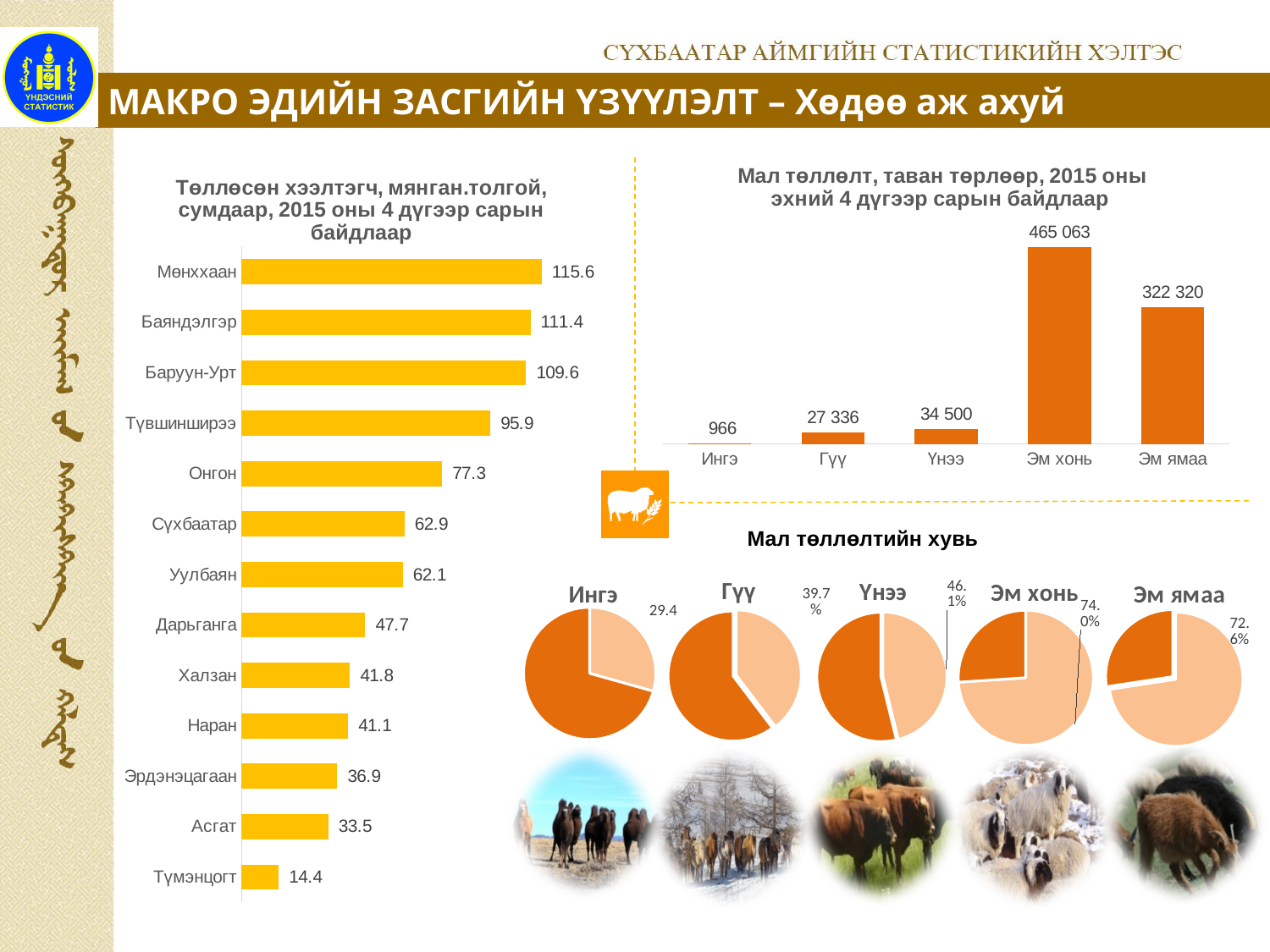
What kind of chart is 'Мал төллөлт, таван төрлөөр'? bar chart In the left bar chart (Төллөсөн хээлтэгч), which sum has the lowest value? Түмэнцогт In the left bar chart (Төллөсөн хээлтэгч), what is the difference between Онгон and Сүхбаатар? 14.4 In the chart titled 'Мал төллөлт, таван төрлөөр', what is the value for Эм хонь? 465 063 In the left bar chart (Төллөсөн хээлтэгч), what is the value for Мөнххаан? 115.6 In the 'Мал төллөлтийн хувь' pie charts, what share is labelled for Эм хонь? 74.0% In the chart titled 'Мал төллөлт, таван төрлөөр', what is the difference between Үнээ and Гүү? 7 164 In the left bar chart (Төллөсөн хээлтэгч), which sum has the highest value? Мөнххаан In the left bar chart (Төллөсөн хээлтэгч), which is larger, Халзан or Наран? Халзан How many pie charts are shown under 'Мал төллөлтийн хувь'? 5 In the left bar chart (Төллөсөн хээлтэгч), how many sums are shown? 13 In the chart titled 'Мал төллөлт, таван төрлөөр', which category has the lowest value? Ингэ